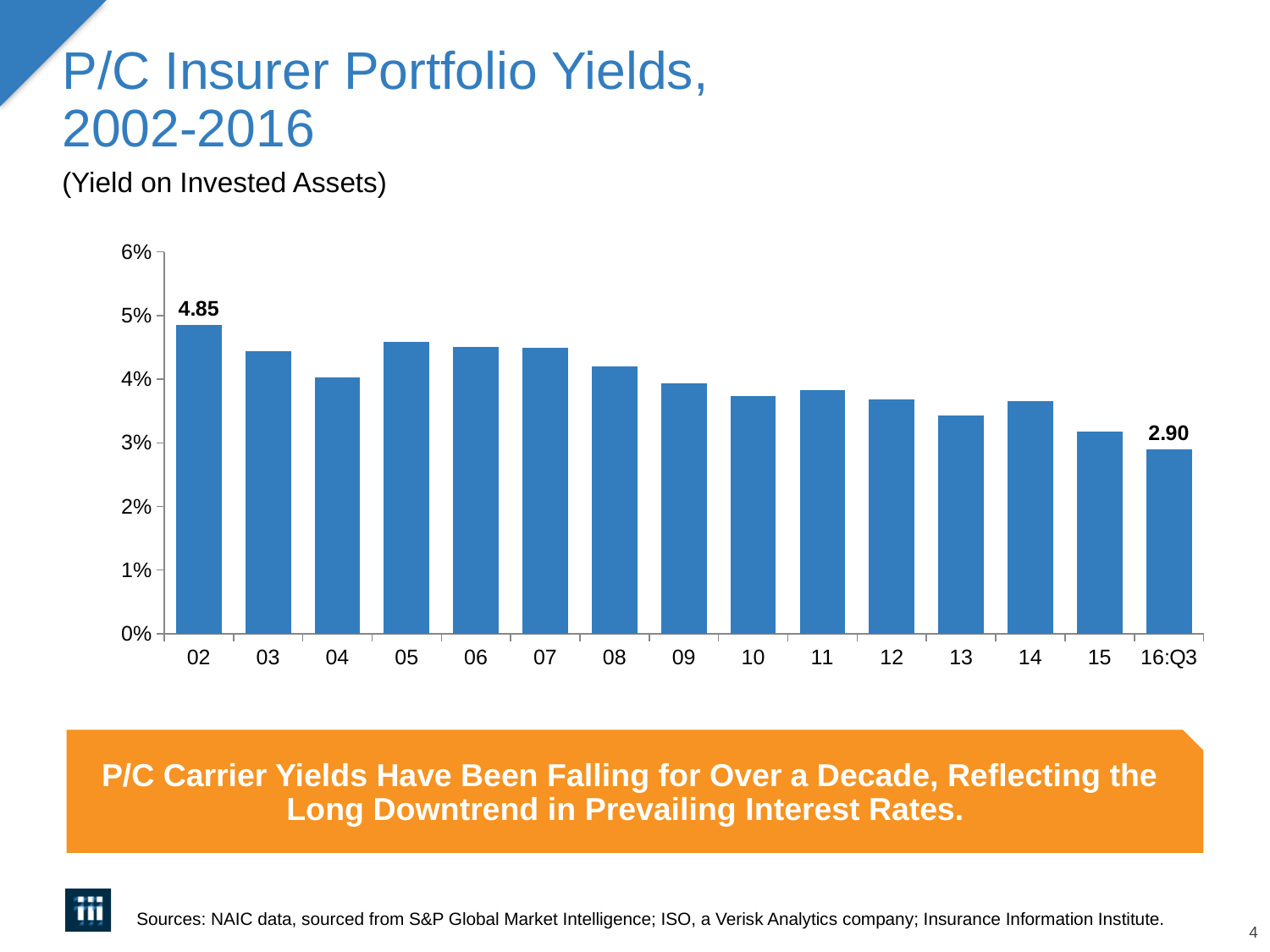
Which year has the highest portfolio yield? 02 What kind of chart is shown on the slide? Bar chart What is the yield on invested assets shown for 02? 4.85 Do the portfolio yields generally rise or fall from 02 to 16:Q3? Fall How many bars are plotted in the chart? 15 Is the value for 13 greater or less than 4%? less What is the difference between the yield for 02 and the yield for 16:Q3? 1.95 What is the yield on invested assets shown for 16:Q3? 2.90 Which has the larger yield, 14 or 15? 14 Which period has the lowest portfolio yield? 16:Q3 Is the value for 05 greater or less than 4%? greater Which has the larger yield, 04 or 05? 05